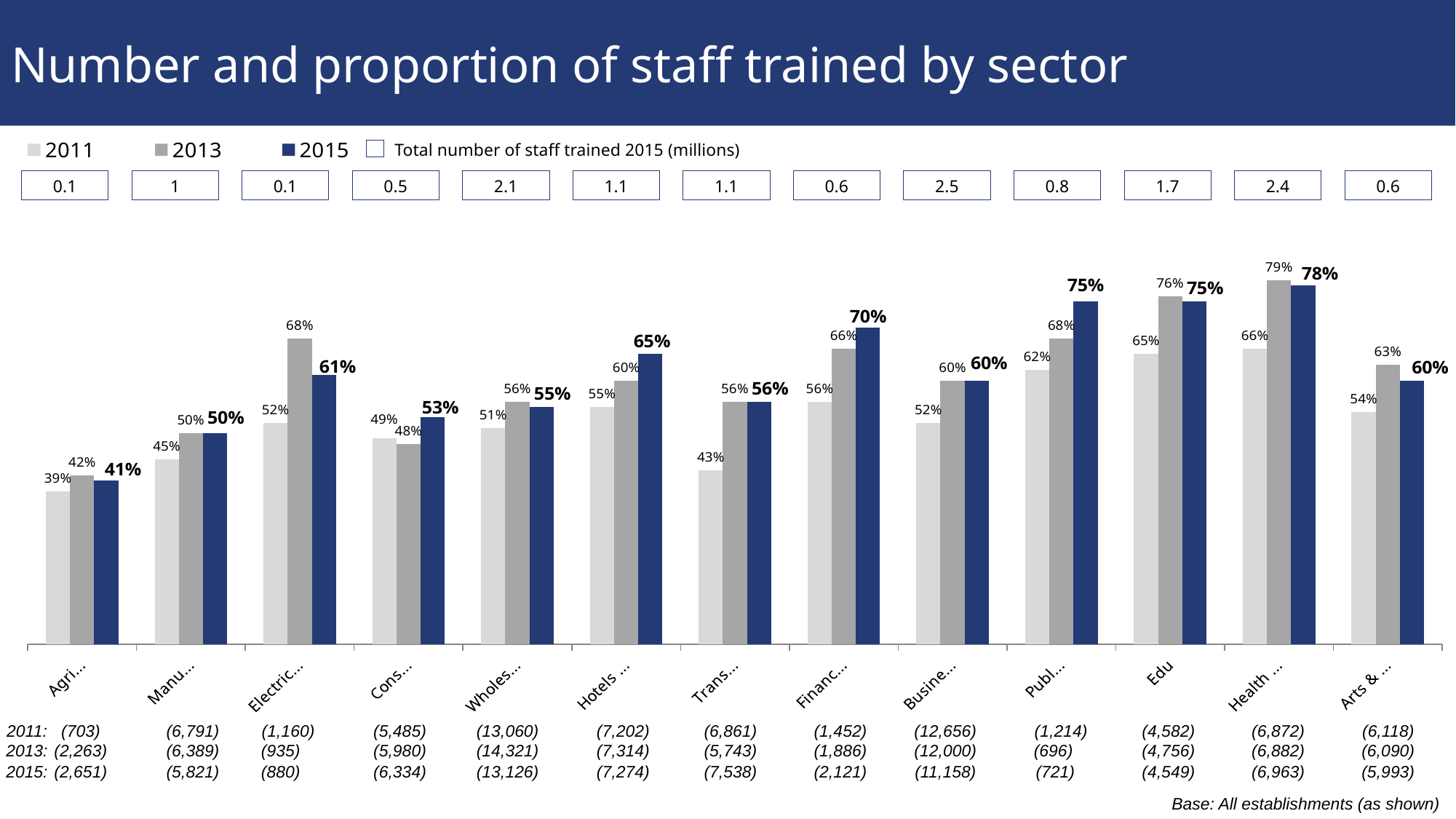
What kind of chart is shown on the slide? bar chart What is the 2011 proportion of staff trained for the Agri... sector? 39% Which sector has the highest 2015 proportion of staff trained? Health ... For the Electric... sector, what is the difference between the 2013 and 2015 proportions of staff trained? 7 percentage points What is the 2015 proportion of staff trained for the Edu sector? 75% What is the 2013 proportion of staff trained for the Financ... sector? 66% How many years are listed as series in the chart legend? 3 Which sector has the lowest 2015 proportion of staff trained? Agri... For the Cons... sector, which year has the larger proportion of staff trained, 2011 or 2013? 2011 How many sectors are shown along the x axis of the chart? 13 For the Hotels ... sector, do the proportions of staff trained rise or fall from 2011 to 2015? rise According to the boxes above the chart, what is the total number of staff trained in 2015 (millions) for the Busine... sector? 2.5